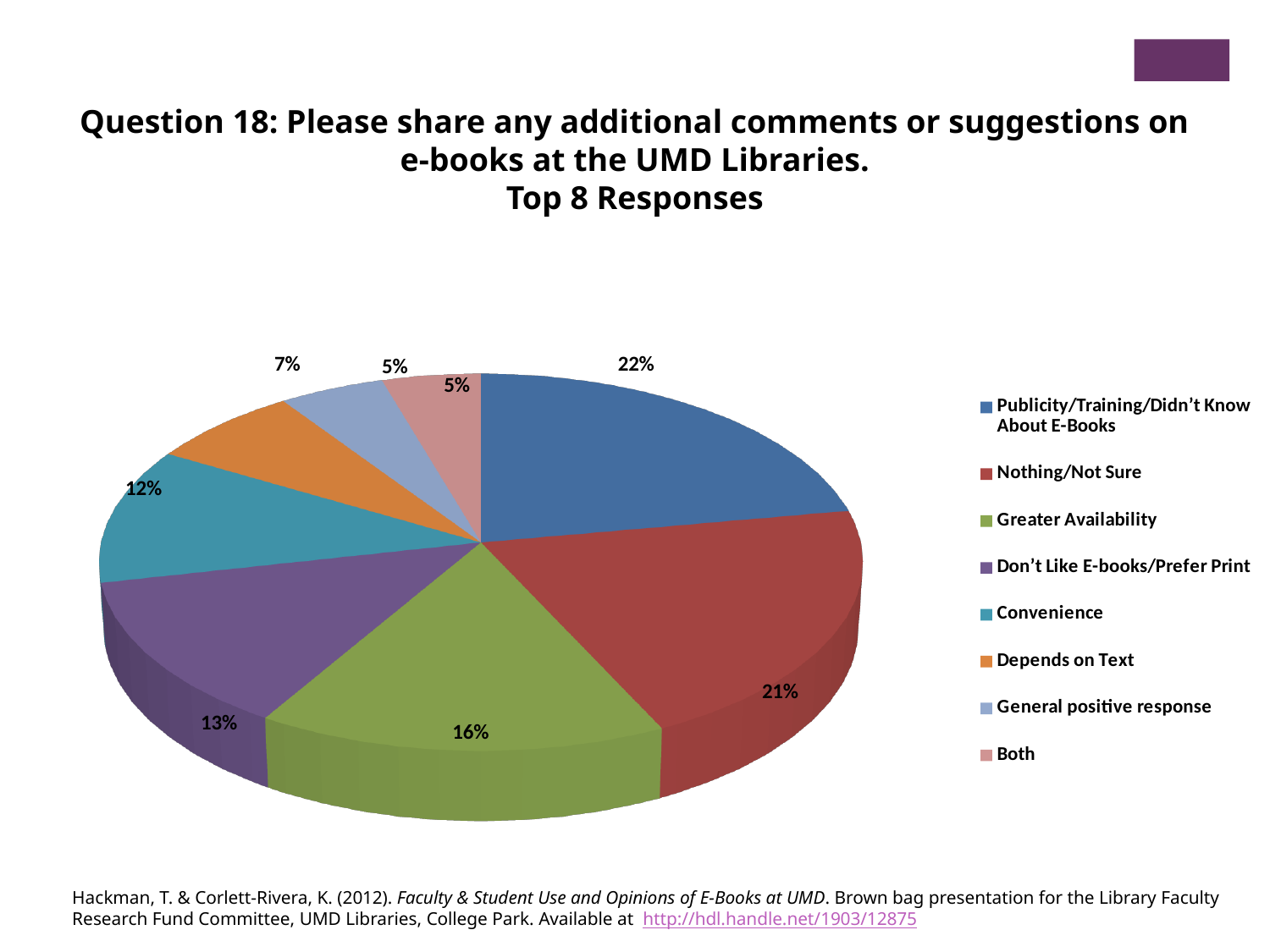
Which is larger, the share for Don't Like E-books/Prefer Print or the share for Depends on Text? Don't Like E-books/Prefer Print How many entries does the legend list? 8 What percentage is shown for Nothing/Not Sure? 21% How many categories does the pie chart show? 8 What is the difference in percentage points between Greater Availability and Convenience? 4 What percentage is shown for Depends on Text? 7% Which category has the largest share of the pie? Publicity/Training/Didn't Know About E-Books What share of responses is labelled for Publicity/Training/Didn't Know About E-Books? 22% What kind of chart is shown on the slide? pie chart What percentage is shown for Don't Like E-books/Prefer Print? 13% What percentage is shown for Convenience? 12% What percentage is shown for Greater Availability? 16%